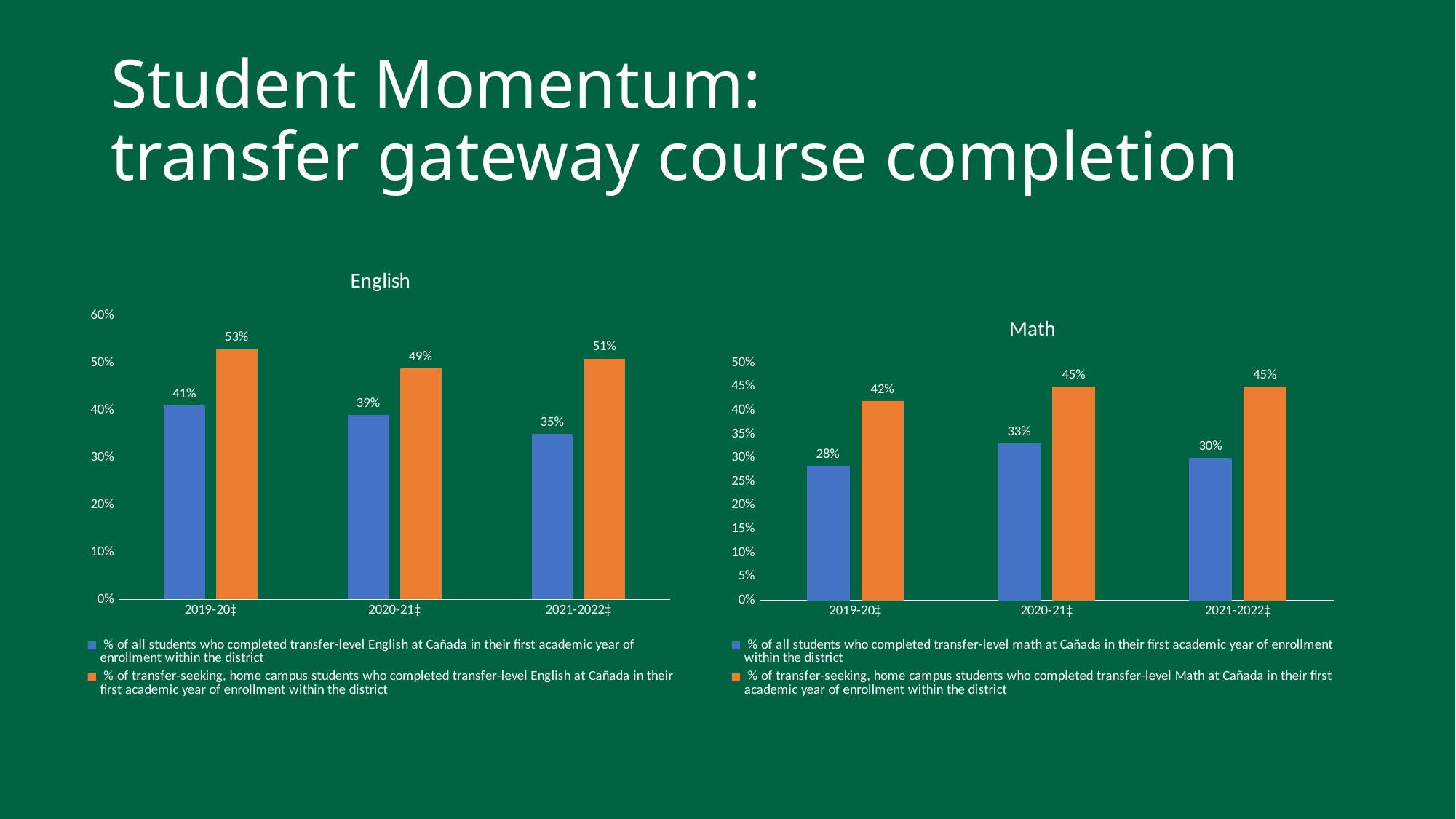
In the Math chart, what is the difference between the all students values for 2020-21‡ and 2019-20‡? 5% In the Math chart, what is the value for all students in 2020-21‡? 33% What kind of chart is the English chart? bar chart How many series does the legend of the Math chart list? 2 In the English chart, what is the difference between the transfer-seeking, home campus students value and the all students value in 2021-2022‡? 16% In the Math chart, what is the value for transfer-seeking, home campus students in 2019-20‡? 42% In the English chart, which year has the highest value for transfer-seeking, home campus students? 2019-20‡ In the English chart, what is the value for transfer-seeking, home campus students in 2021-2022‡? 51% How many year categories are shown on the x axis of the English chart? 3 In the Math chart, which is larger in 2021-2022‡: the all students value or the transfer-seeking, home campus students value? transfer-seeking, home campus students In the English chart, what is the value for all students in 2019-20‡? 41% In the Math chart, which year has the lowest value for all students? 2019-20‡